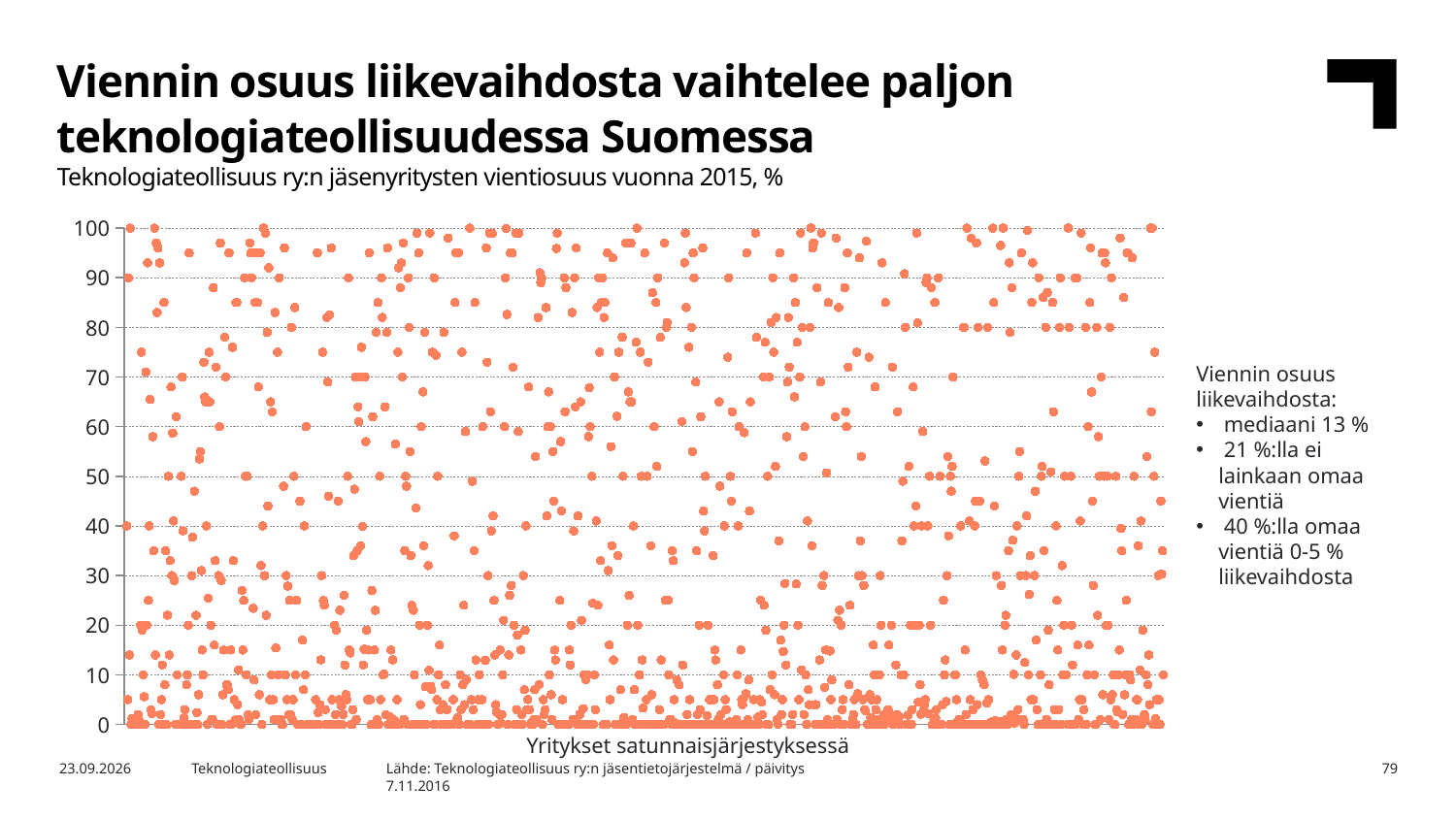
According to the slide, what percentage of companies have no exports at all? 21 % What is the label of the x axis of the chart? Yritykset satunnaisjärjestyksessä According to the slide, what percentage of companies have exports of 0-5 % of turnover? 40 % According to the slide, what is the median export share of turnover (mediaani)? 13 % Which year does the chart's data refer to? 2015 What is the lowest value shown on the y axis of the chart? 0 What kind of chart is shown on the slide? scatter chart What is the interval between consecutive tick marks on the y axis? 10 What is the highest value shown on the y axis of the chart? 100